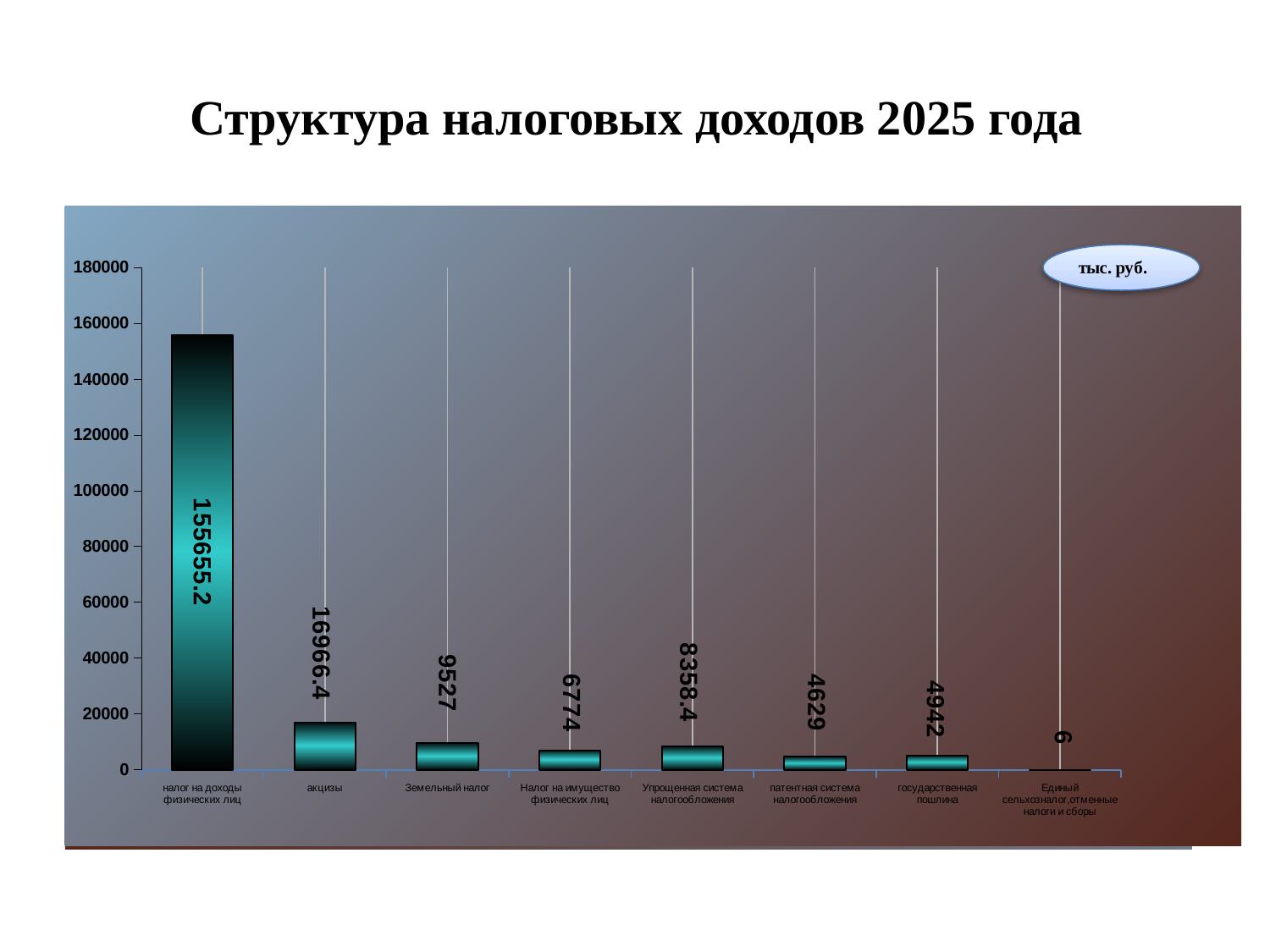
Is the value for акцизы greater or less than 20000? less Which is larger, the value for патентная система налогообложения or the value for государственная пошлина? государственная пошлина What is the value for государственная пошлина? 4942 What is the value for Упрощенная система налогообложения? 8358.4 What is the value for Земельный налог? 9527 What is the difference between the values for Земельный налог and Налог на имущество физических лиц? 2753 Which category has the lowest value? Единый сельхозналог, отменные налоги и сборы How many categories are shown on the x axis? 8 What is the value for акцизы? 16966.4 What is the value for налог на доходы физических лиц? 155655.2 What kind of chart is shown on the slide? bar chart Which category has the highest value? налог на доходы физических лиц